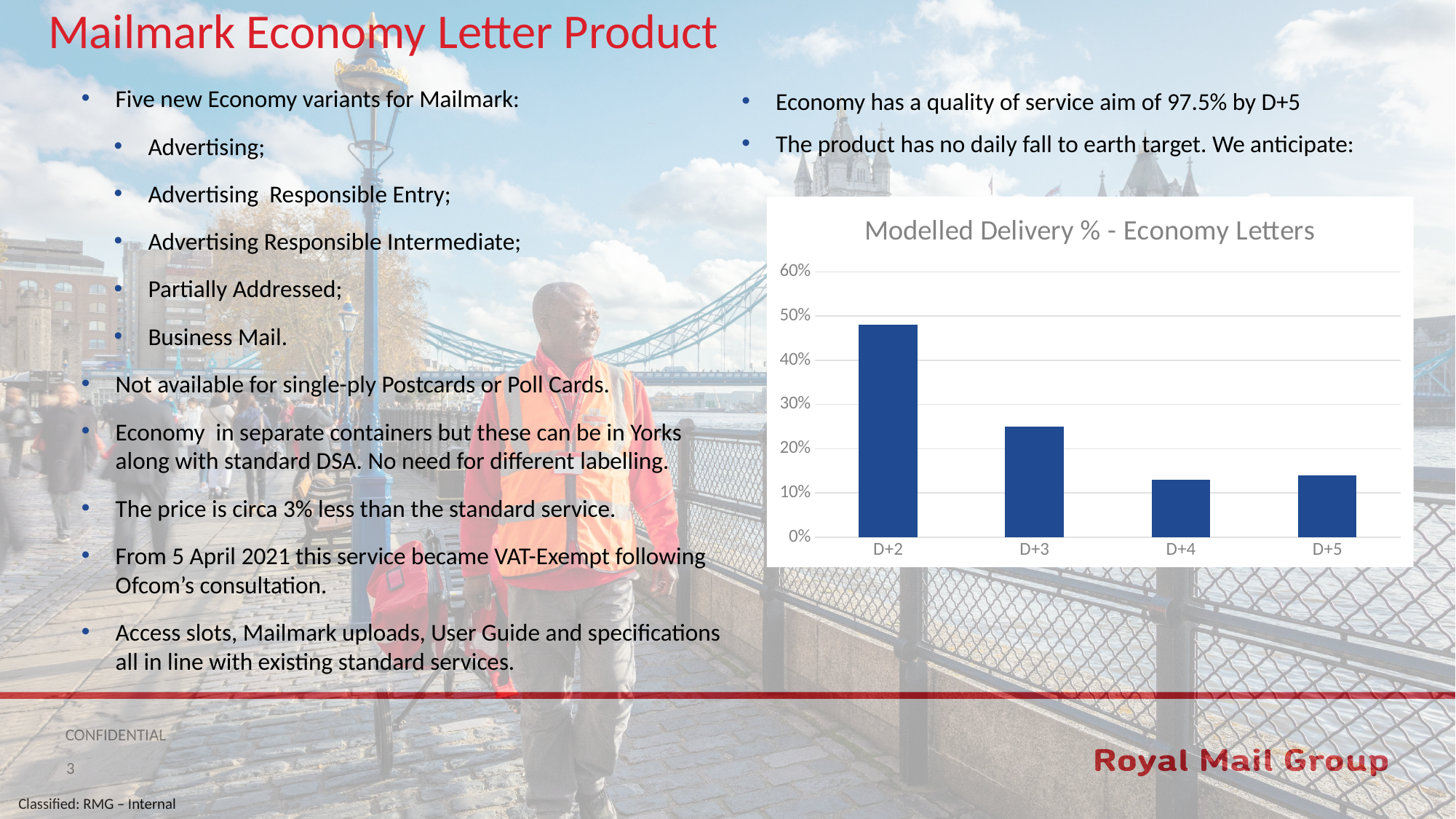
Which is larger, the value for D+2 or the value for D+3? D+2 What is the title of the chart on the slide? Modelled Delivery % - Economy Letters Which is larger, the value for D+3 or the value for D+5? D+3 What kind of chart is shown on the slide? bar chart Is the value for D+3 greater or less than 20%? greater Is the value for D+4 greater or less than 20%? less Is the value for D+3 greater or less than 30%? less Do the values rise or fall from D+2 to D+4? fall How many categories are plotted on the x axis of the chart? 4 Which category has the highest modelled delivery percentage? D+2